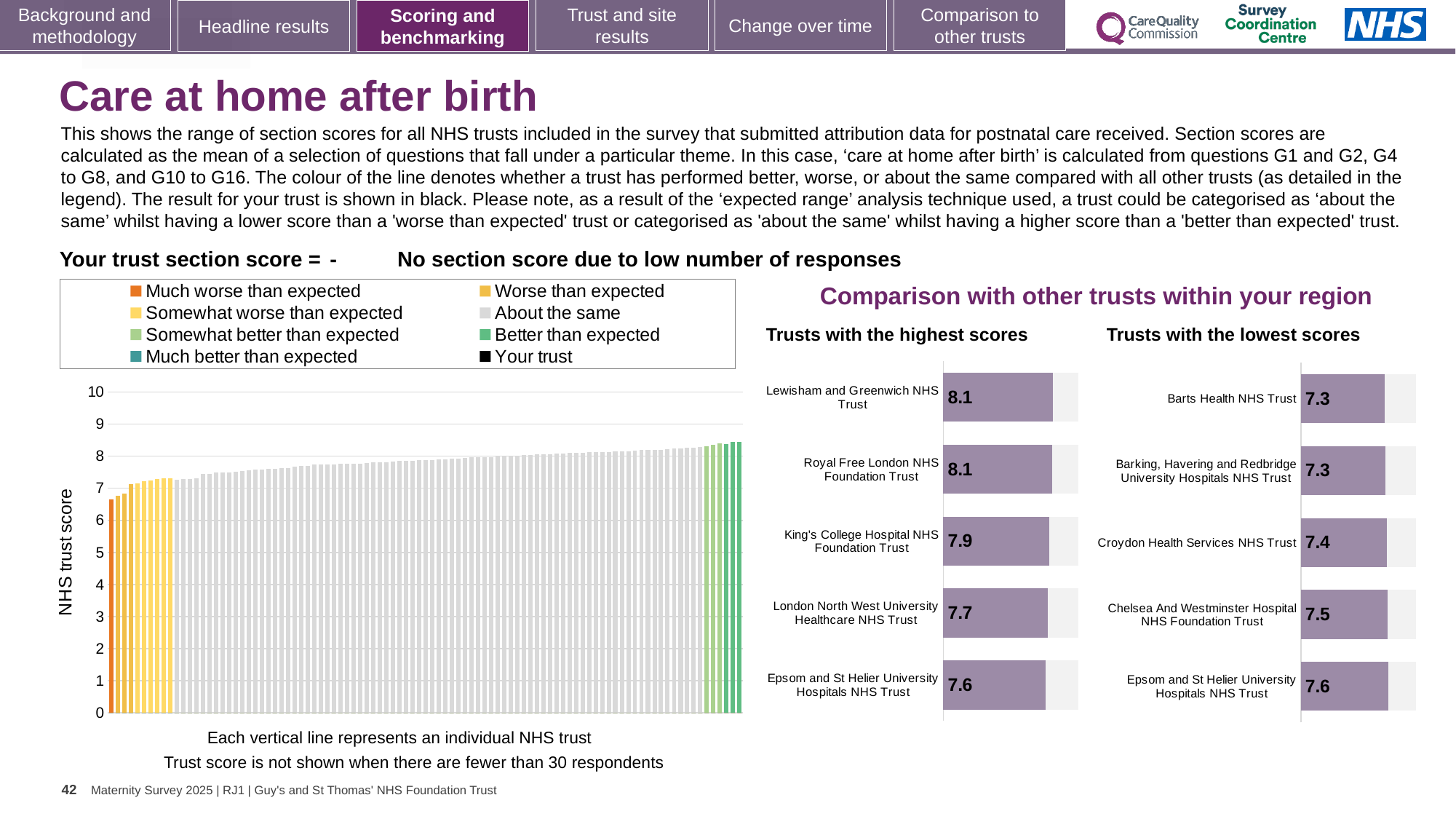
In the 'Trusts with the highest scores' chart, what is the difference between the scores of King's College Hospital NHS Foundation Trust and London North West University Healthcare NHS Trust? 0.2 How many trusts are shown in the 'Trusts with the lowest scores' chart? 5 In the 'Trusts with the lowest scores' chart, what is the score for Chelsea And Westminster Hospital NHS Foundation Trust? 7.5 In the 'Trusts with the highest scores' chart, what is the score for London North West University Healthcare NHS Trust? 7.7 In the 'Trusts with the lowest scores' chart, what is the score for Croydon Health Services NHS Trust? 7.4 In the 'Trusts with the highest scores' chart, what is the score for King's College Hospital NHS Foundation Trust? 7.9 In the main NHS trust score chart, do the bar values rise or fall from left to right? Rise What kind of chart is the main chart with the 'NHS trust score' axis? Bar chart In the 'Trusts with the highest scores' chart, which trust has the lowest score? Epsom and St Helier University Hospitals NHS Trust In the 'Trusts with the lowest scores' chart, which trust has the highest score? Epsom and St Helier University Hospitals NHS Trust In the 'Trusts with the lowest scores' chart, which has the larger score: Barts Health NHS Trust or Chelsea And Westminster Hospital NHS Foundation Trust? Chelsea And Westminster Hospital NHS Foundation Trust How many entries does the legend of the main NHS trust score chart list? 8